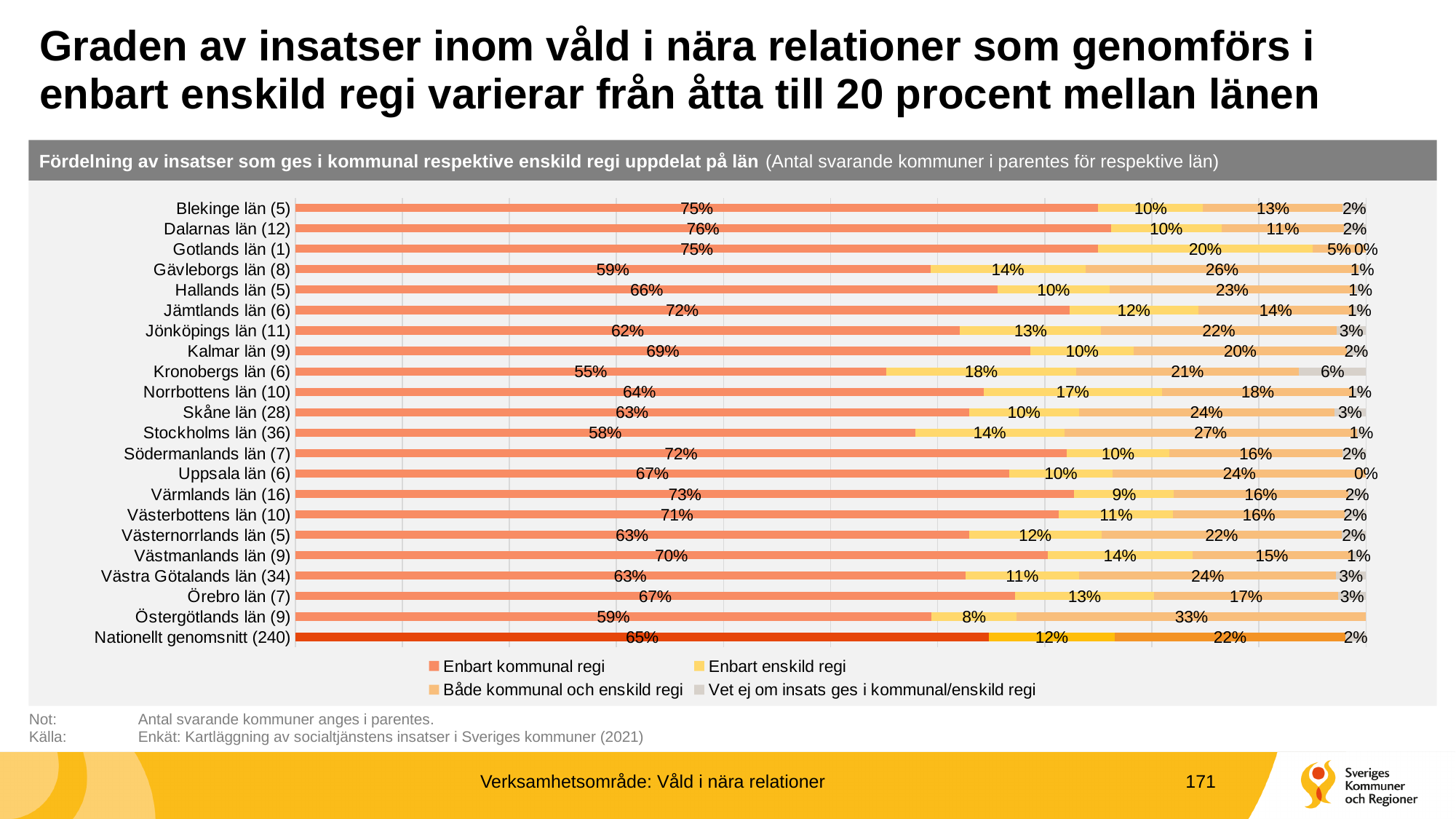
What is the value of 'Både kommunal och enskild regi' for Östergötlands län (9)? 33% How many series does the legend list? 4 What type of chart is shown on the slide? Stacked bar chart Which län has the lowest value for 'Enbart enskild regi'? Östergötlands län (9) Which län has the lowest value for 'Enbart kommunal regi'? Kronobergs län (6) Which has a larger 'Både kommunal och enskild regi' value, Stockholms län (36) or Skåne län (28)? Stockholms län (36) Which län has the highest value for 'Enbart kommunal regi'? Dalarnas län (12) What is the value of 'Enbart enskild regi' for Gotlands län (1)? 20% Which län has the highest value for 'Vet ej om insats ges i kommunal/enskild regi'? Kronobergs län (6) What is the value of 'Enbart kommunal regi' for Nationellt genomsnitt (240)? 65% How many bars (categories) are plotted in the chart? 22 What is the difference between the 'Enbart kommunal regi' values for Dalarnas län (12) and Kronobergs län (6)? 21 percentage points